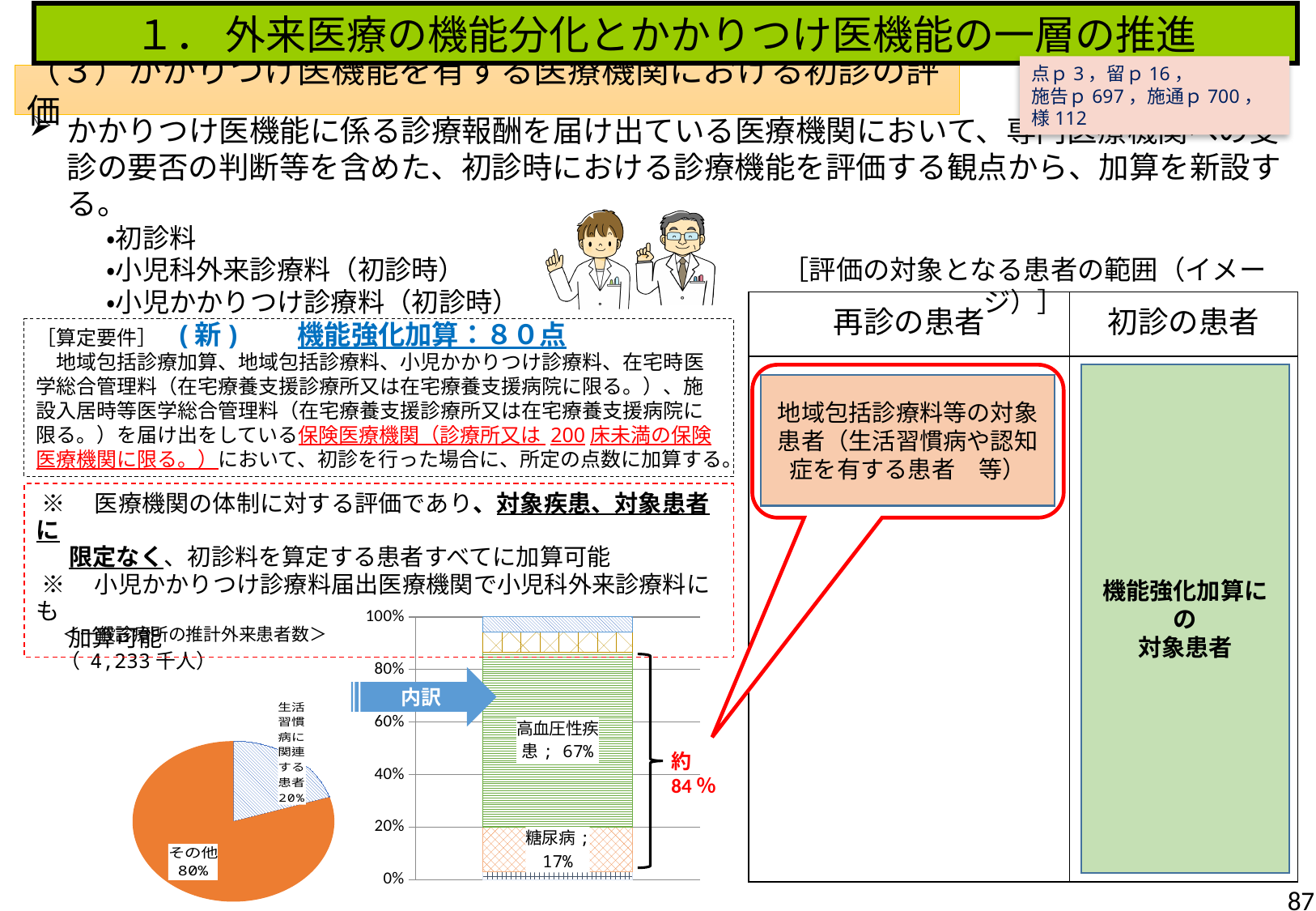
In the pie chart at the bottom left, what share is labelled 生活習慣病に関連する患者? 20% In the stacked bar chart at the bottom centre, what is the combined total of the 高血圧性疾患 and 糖尿病 segments? 84% In the stacked bar chart at the bottom centre, what value is shown for 高血圧性疾患? 67% What kind of chart is the chart at the bottom left of the slide? pie chart In the stacked bar chart at the bottom centre, which labelled segment is larger, 高血圧性疾患 or 糖尿病? 高血圧性疾患 What kind of chart is the chart at the bottom centre of the slide? bar chart In the pie chart at the bottom left, what share is labelled その他? 80% In the stacked bar chart at the bottom centre, what value is shown for 糖尿病? 17% In the pie chart at the bottom left, which slice is larger, その他 or 生活習慣病に関連する患者? その他 In the pie chart at the bottom left, what is the difference between the その他 share and the 生活習慣病に関連する患者 share? 60% In the stacked bar chart at the bottom centre, what is the difference between the 高血圧性疾患 value and the 糖尿病 value? 50% In the pie chart at the bottom left, how many slices are labelled? 2